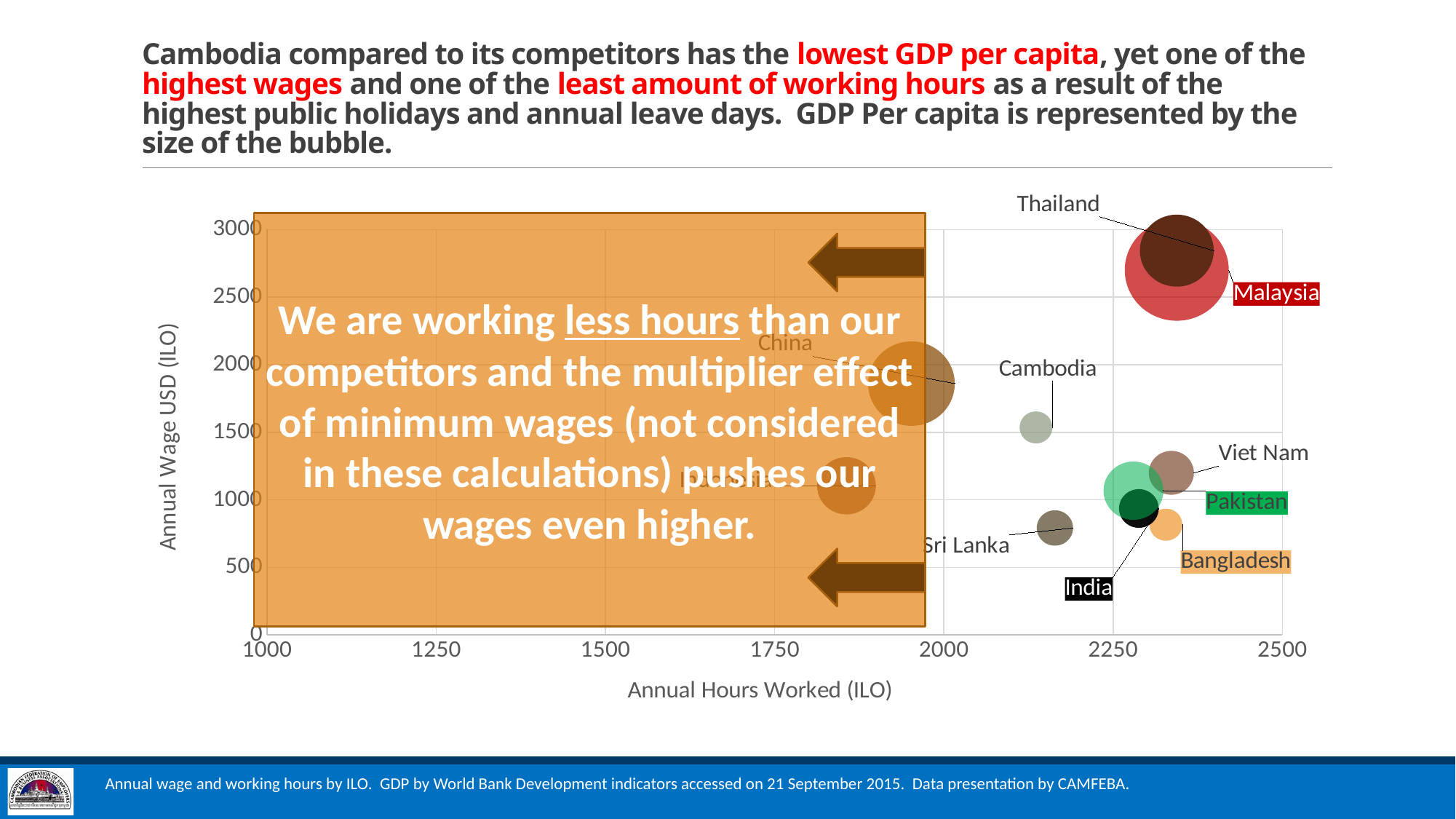
Is the annual wage for China greater or less than 1500? greater Are the annual hours worked for Cambodia greater or less than 2000? greater Are the annual hours worked for Malaysia greater or less than 2250? greater What is the title of the y axis of the chart? Annual Wage USD (ILO) Which country has the largest bubble on the chart? Malaysia Which has the higher annual wage, Cambodia or Sri Lanka? Cambodia Which has more annual hours worked, China or Cambodia? Cambodia What kind of chart is shown on the slide? Bubble chart What is the title of the x axis of the chart? Annual Hours Worked (ILO)